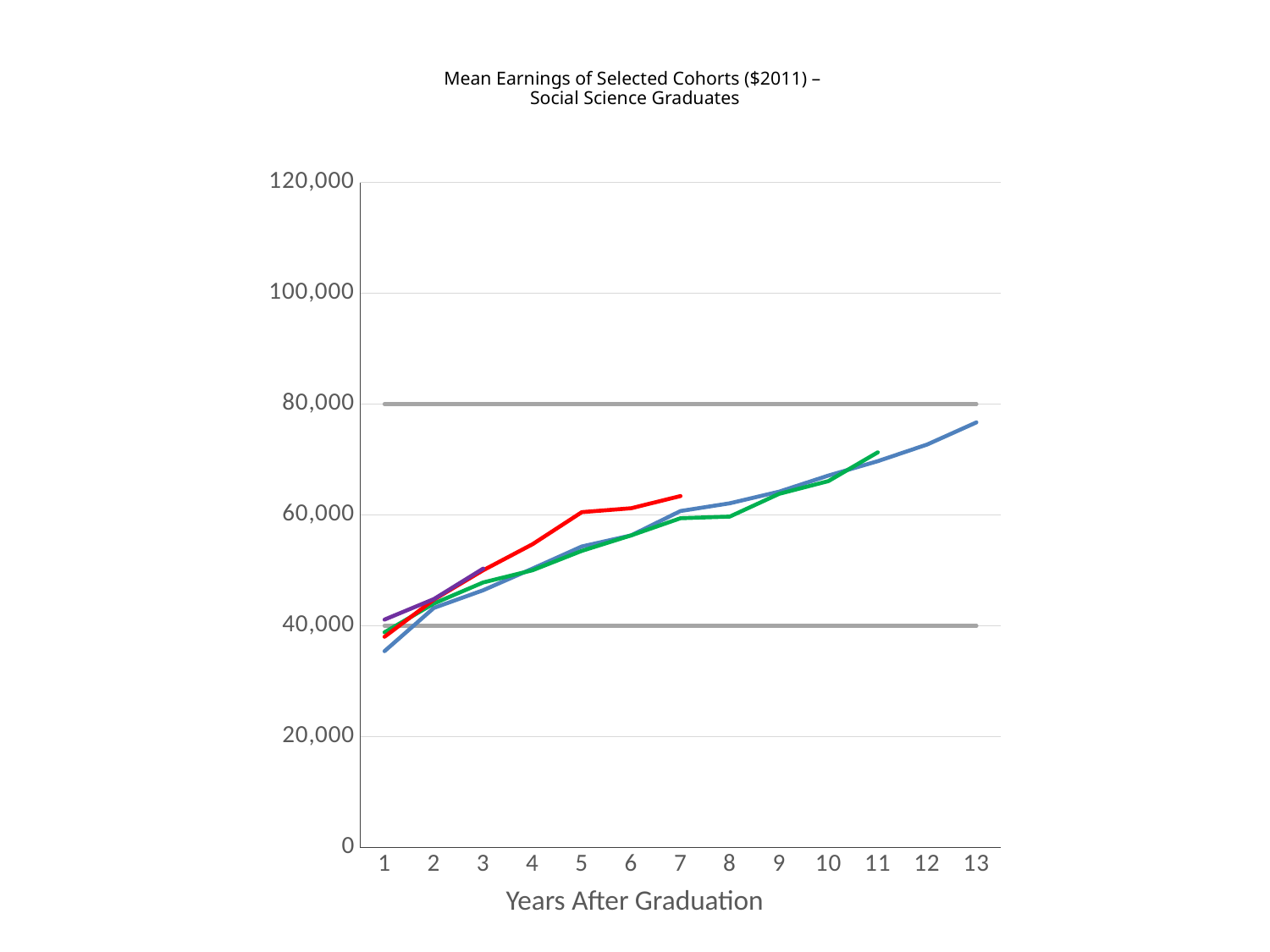
How many years after graduation are marked along the x axis? 13 Which coloured line extends to the largest number of years after graduation? blue What is the title of the chart? Mean Earnings of Selected Cohorts ($2011) – Social Science Graduates Is the value of the blue line at year 13 greater or less than 80,000? less What is the label on the x axis of the chart? Years After Graduation What kind of chart is shown on the slide? line chart At what value does the upper grey horizontal reference line sit? 80,000 Is the value of the red line at year 7 greater or less than 60,000? greater Do the earnings of the blue line rise or fall as years after graduation increase? rise Is the value of the blue line at year 1 greater or less than 40,000? less At what value does the lower grey horizontal reference line sit? 40,000